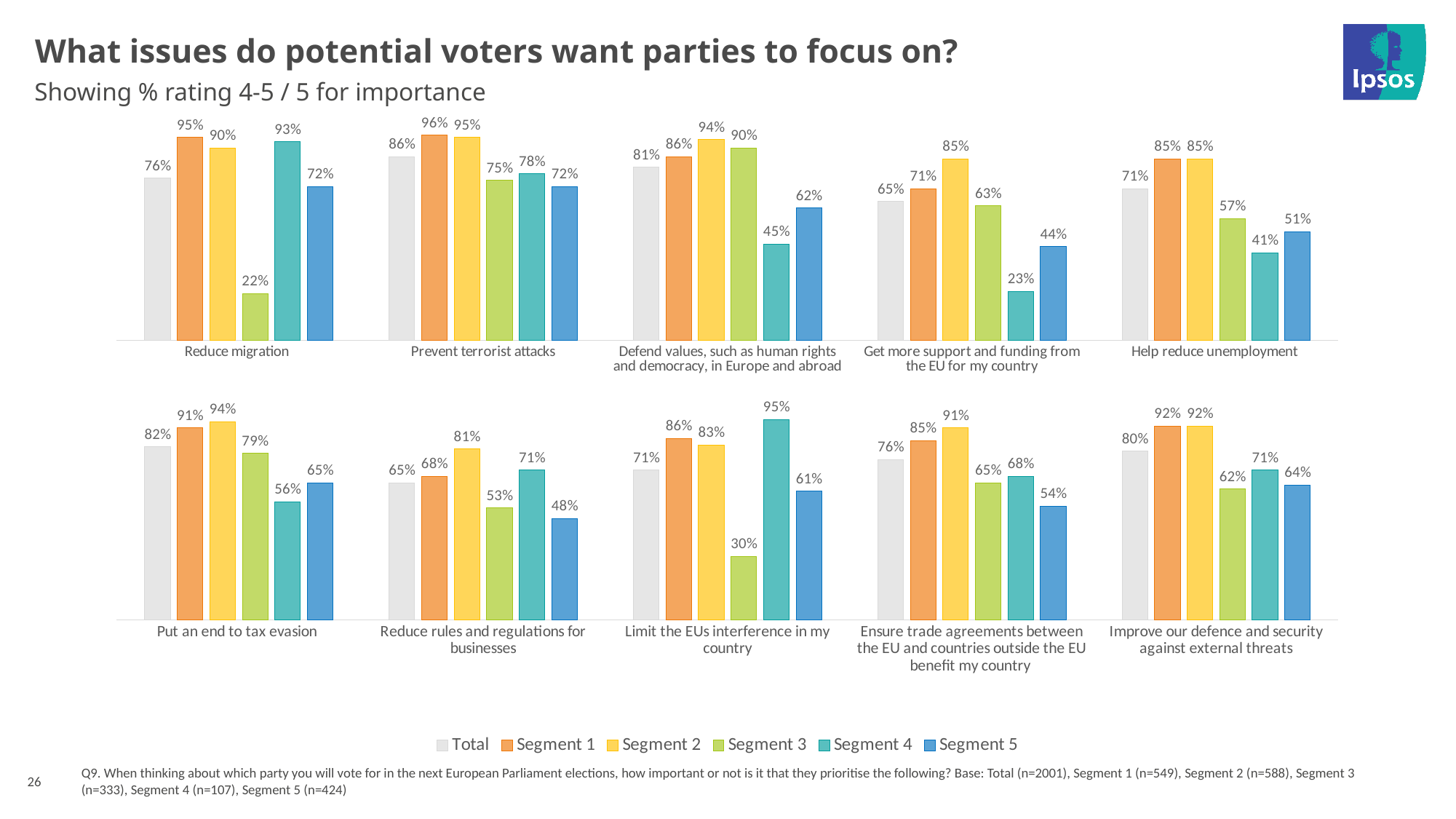
What type of chart is used on this slide? Bar chart In the top chart, what is the Total value for Reduce migration? 76% How many categories are shown in the bottom chart? 5 In the top chart, which segment has the highest value for Prevent terrorist attacks? Segment 1 In the bottom chart, what is the difference between the Segment 1 and Total values for Put an end to tax evasion? 9% In the bottom chart, what is the Segment 4 value for Limit the EUs interference in my country? 95% In the top chart, which segment has the lowest value for Get more support and funding from the EU for my country? Segment 4 How many series does the legend list? 6 In the bottom chart, which segment has the lowest value for Reduce rules and regulations for businesses? Segment 5 In the top chart, for Help reduce unemployment, which is larger: the Segment 4 value or the Segment 5 value? Segment 5 In the top chart, what is the Segment 3 value for Reduce migration? 22% In the top chart, what is the difference between the Segment 2 and Segment 3 values for Defend values, such as human rights and democracy, in Europe and abroad? 4%